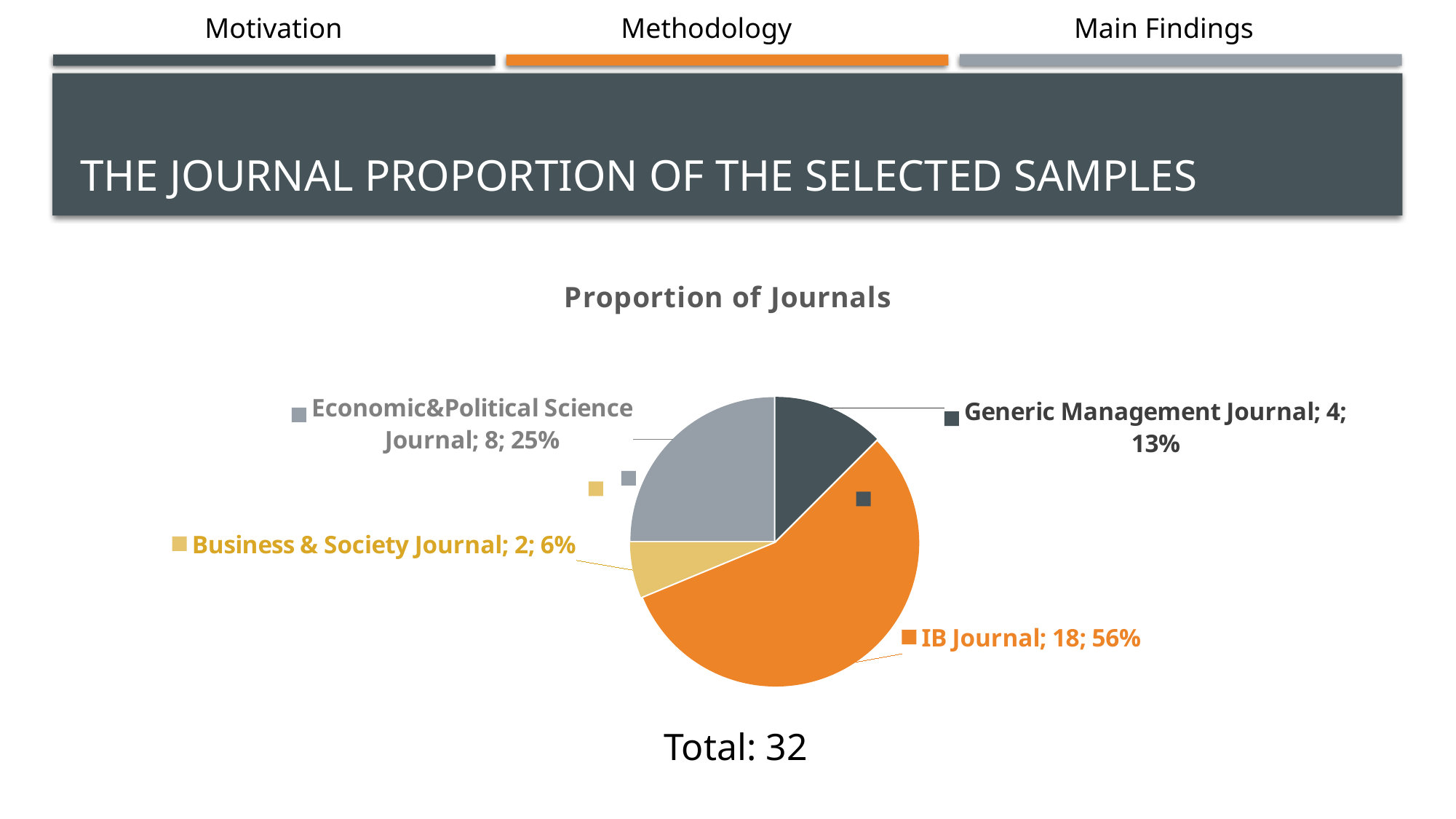
How many samples come from the IB Journal? 18 What is the title of the chart? Proportion of Journals Which journal has the largest share of the selected samples? IB Journal What is the total number of samples shown below the chart? 32 What is the difference in the number of samples between the IB Journal and the Economic&Political Science Journal? 10 What percentage share does the Economic&Political Science Journal have? 25% Which has more samples, the Generic Management Journal or the Business & Society Journal? Generic Management Journal What kind of chart is shown on the slide? Pie chart Which journal has the smallest share of the selected samples? Business & Society Journal How many samples come from the Business & Society Journal? 2 How many journal categories does the pie chart show? 4 What percentage share does the Generic Management Journal have? 13%